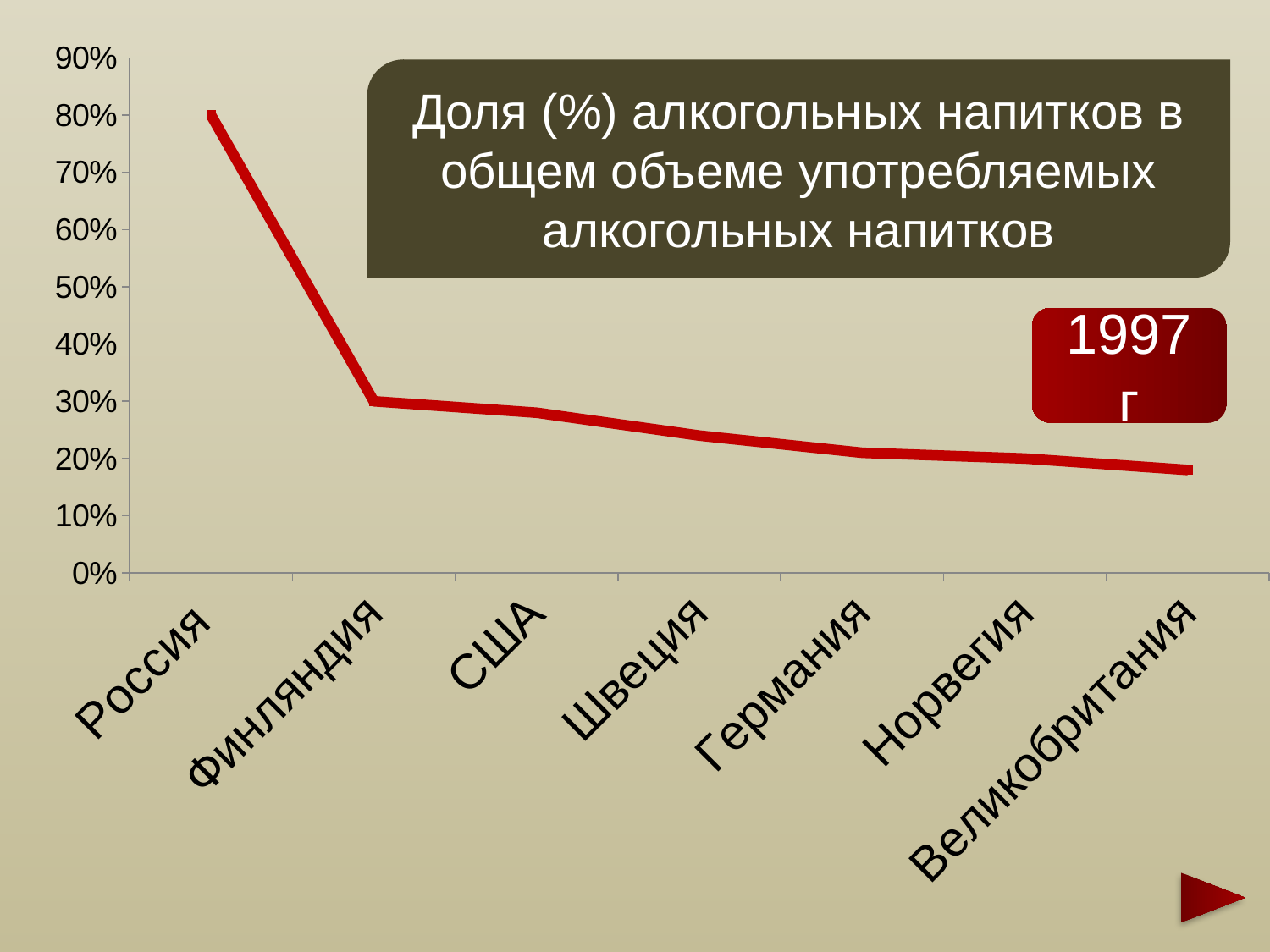
What kind of chart is shown on the slide? line chart Which country has the highest value on the chart? Россия Is the value for Финляндия greater or less than 50%? less Is the value for Россия greater or less than 70%? greater Which country has the lowest value on the chart? Великобритания How many countries are plotted along the x axis? 7 What is the value for Россия? 80% Is the value for Великобритания greater or less than 20%? less Which year is shown in the red box on the slide? 1997 г Do the values rise or fall moving from Россия to Великобритания along the x axis? fall Which is larger, the value for Финляндия or the value for Швеция? Финляндия